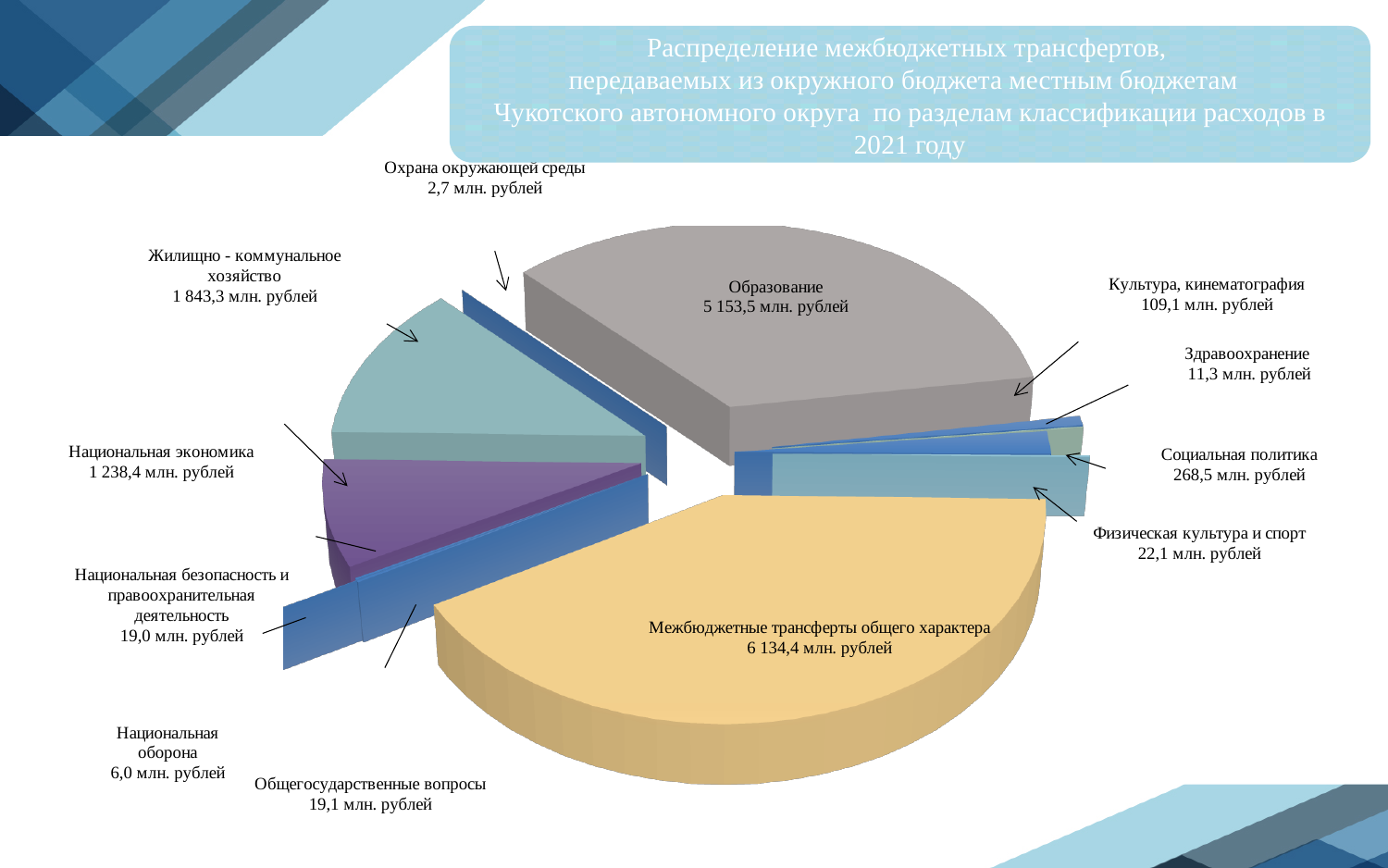
Which year does the chart title say the distribution refers to? 2021 What is the difference between Жилищно-коммунальное хозяйство and Национальная экономика? 604,9 млн. рублей How many categories (slices) does the pie chart show? 12 Which category has the smallest value in the pie chart? Охрана окружающей среды What is the value shown for Жилищно-коммунальное хозяйство? 1 843,3 млн. рублей Which category has the largest value in the pie chart? Межбюджетные трансферты общего характера What is the value shown for Социальная политика? 268,5 млн. рублей What is the value shown for Образование? 5 153,5 млн. рублей Which is larger: Образование or Межбюджетные трансферты общего характера? Межбюджетные трансферты общего характера What is the value shown for Национальная оборона? 6,0 млн. рублей What is the difference between Межбюджетные трансферты общего характера and Образование? 980,9 млн. рублей What kind of chart is shown on the slide? Pie chart